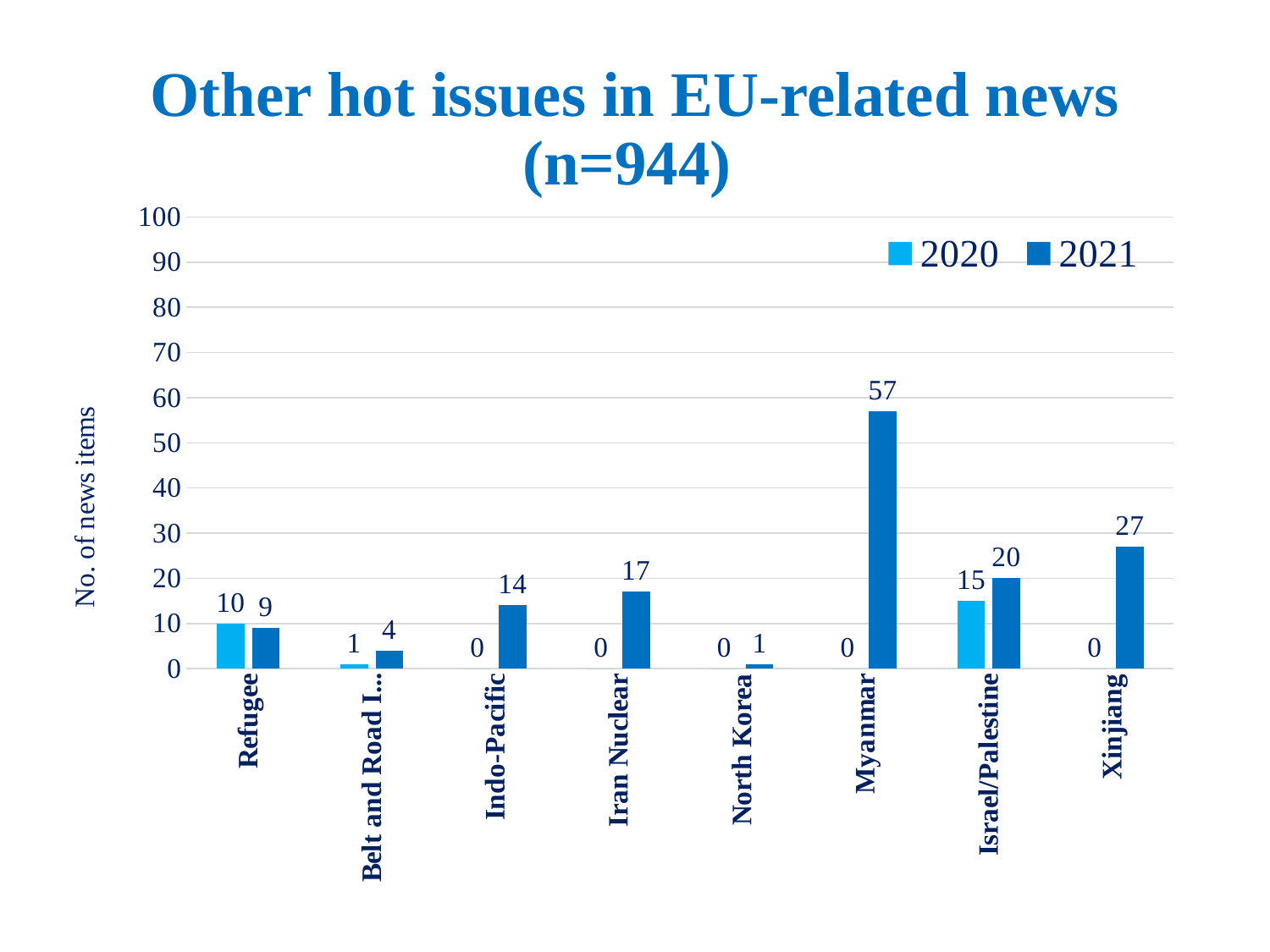
Is the 2021 value for Myanmar greater or less than 50? greater What is the 2021 value for Myanmar? 57 What kind of chart is shown on the slide? bar chart What is the difference between the 2021 and 2020 values for Israel/Palestine? 5 Which category has the highest 2021 value? Myanmar What is the 2021 value for Xinjiang? 27 Which category has the highest 2020 value? Israel/Palestine How many series does the legend list? 2 What is the 2020 value for Israel/Palestine? 15 Which is larger for Refugee, the 2020 value or the 2021 value? 2020 What is the 2020 value for Refugee? 10 How many categories are shown on the x axis? 8